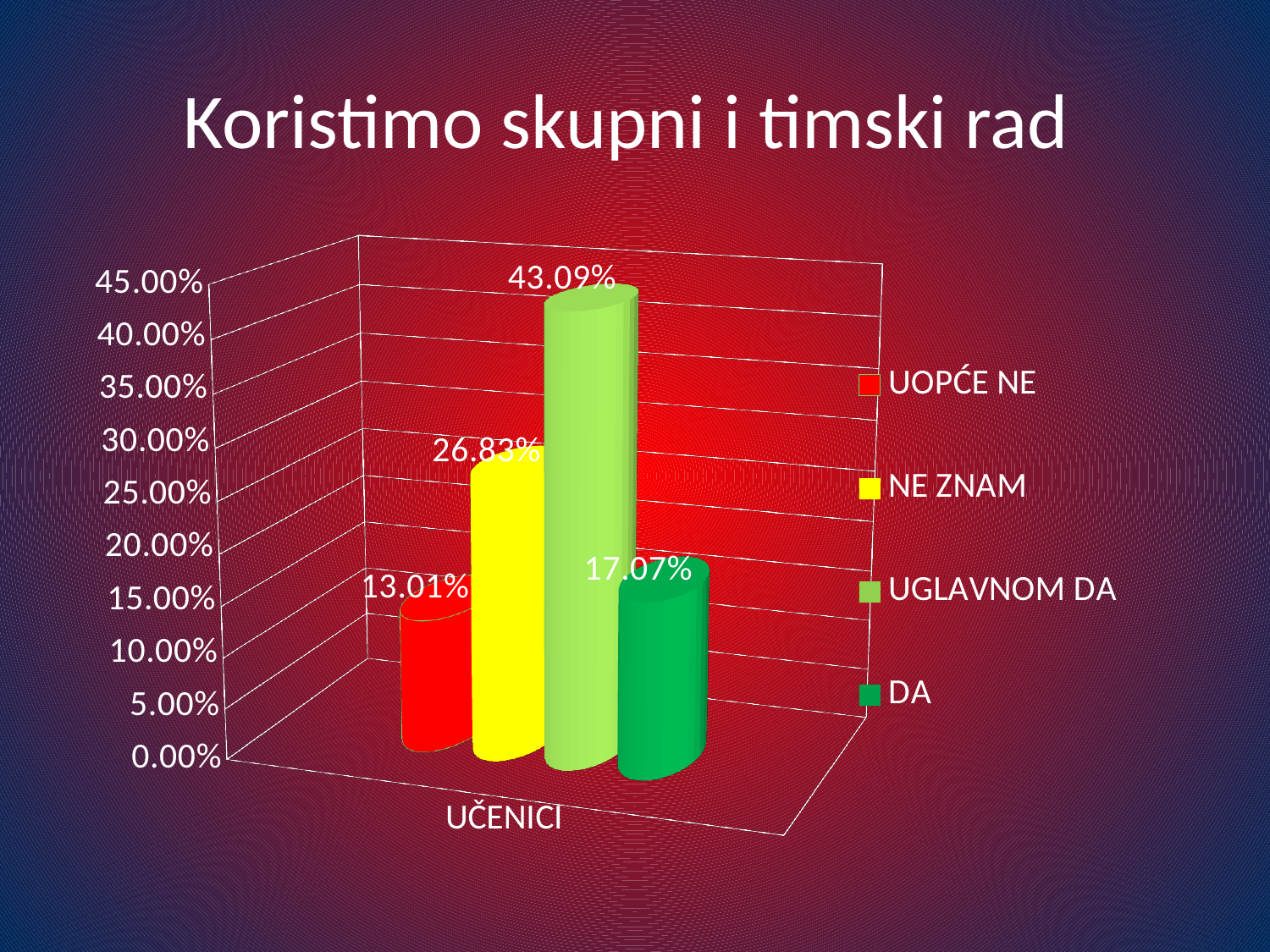
What is the value for DA? 17.07% Which series has the highest value? UGLAVNOM DA What kind of chart is shown on the slide? Bar chart What is the value for NE ZNAM? 26.83% What is the value for UGLAVNOM DA? 43.09% Which series has the lowest value? UOPĆE NE What is the title of the chart? Koristimo skupni i timski rad Which is larger, the value for DA or the value for NE ZNAM? NE ZNAM How many series does the legend list? 4 What is the difference between the values for UGLAVNOM DA and NE ZNAM? 16.26% What is the value for UOPĆE NE? 13.01% What is the difference between the values for DA and UOPĆE NE? 4.06%